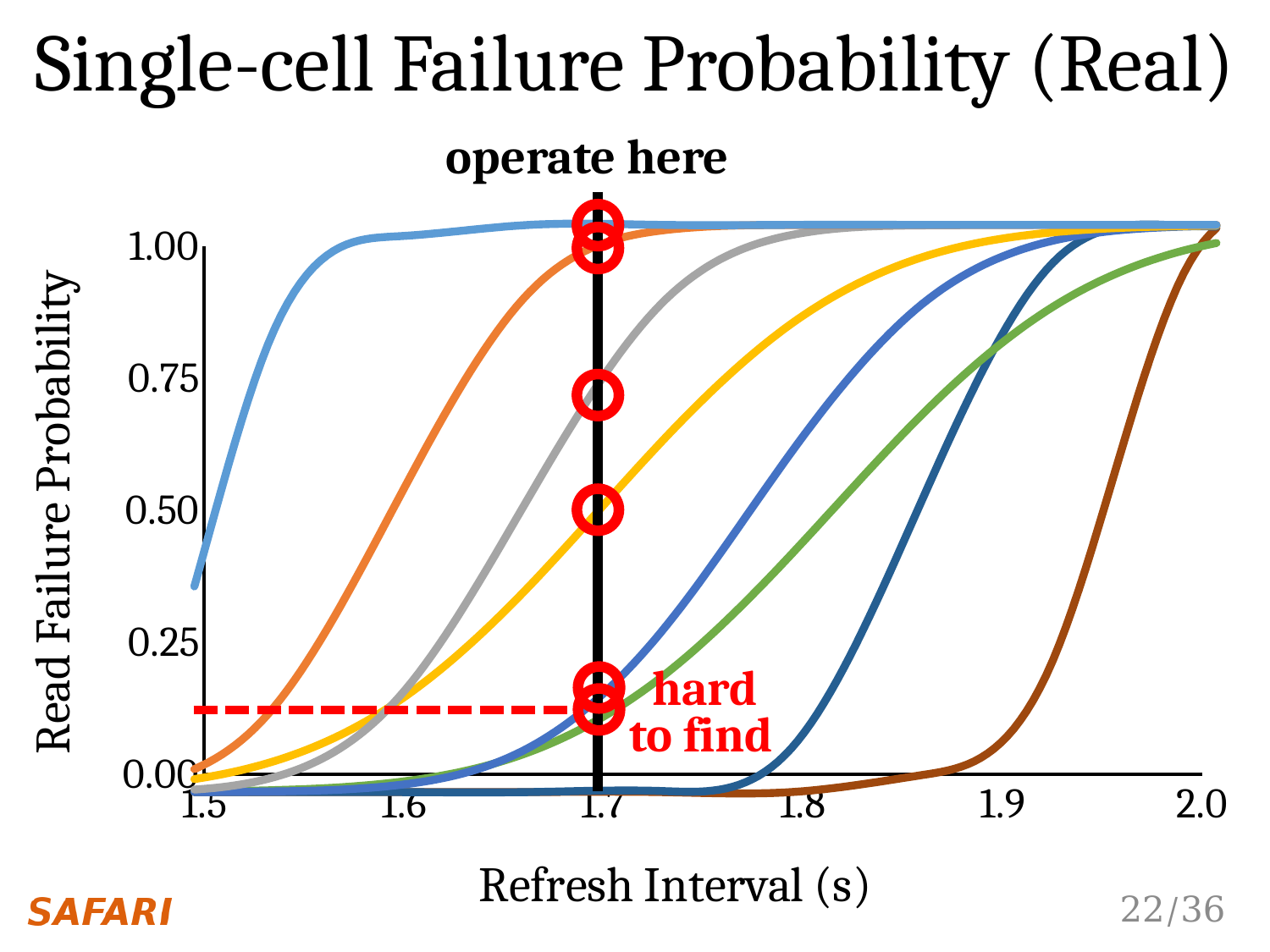
How many curves are plotted on the chart? 8 How many red circles are marked on the vertical line at 1.7? 6 Is the value of the orange curve at a refresh interval of 1.7 greater or less than 0.75? greater What is the range of the x axis, from its first tick to its last tick? 1.5 to 2.0 At what refresh interval is the vertical 'operate here' line drawn? 1.7 What is the label of the y axis? Read Failure Probability Do the curves rise or fall as the refresh interval increases along the x axis? rise What kind of chart is shown on the slide? line chart What is the label of the x axis? Refresh Interval (s) Is the value of the rightmost (brown) curve at a refresh interval of 1.8 greater or less than 0.25? less What is the highest tick value shown on the y axis? 1.00 Is the value of the leftmost (light blue) curve at a refresh interval of 1.6 greater or less than 0.75? greater